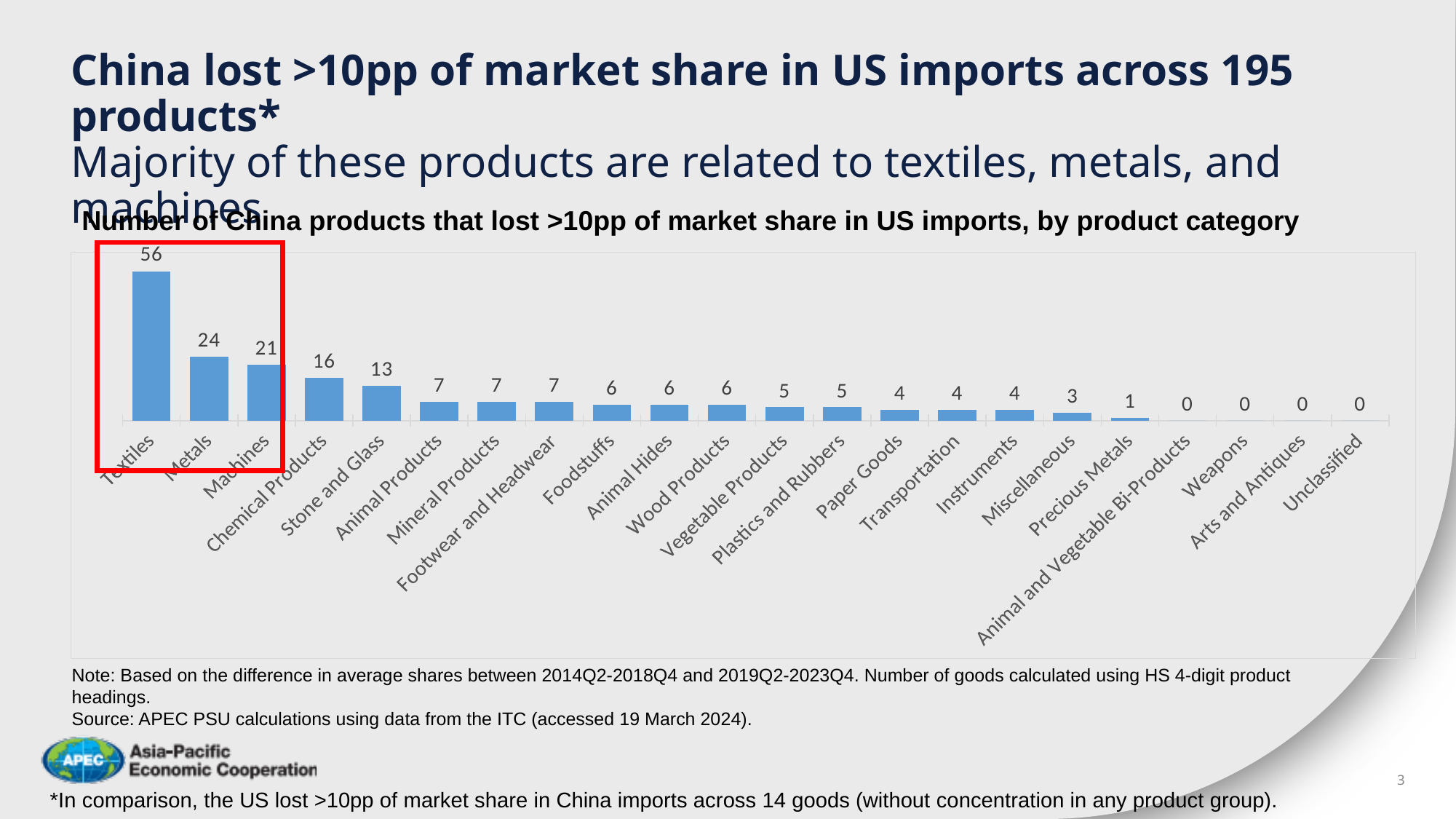
Which product category has the highest number of products that lost >10pp of market share? Textiles What is the value shown for Chemical Products? 16 What is the difference between the values for Textiles and Metals? 32 What is the value shown for Precious Metals? 1 What is the number of China products that lost >10pp of market share for Textiles? 56 What is the value shown for Stone and Glass? 13 What is the difference between the values for Machines and Chemical Products? 5 How many product categories are shown on the x axis of the chart? 22 What type of chart is shown on the slide? bar chart How many product categories have a value of 0? 4 Which has a larger value, Metals or Machines? Metals Which has a larger value, Paper Goods or Miscellaneous? Paper Goods